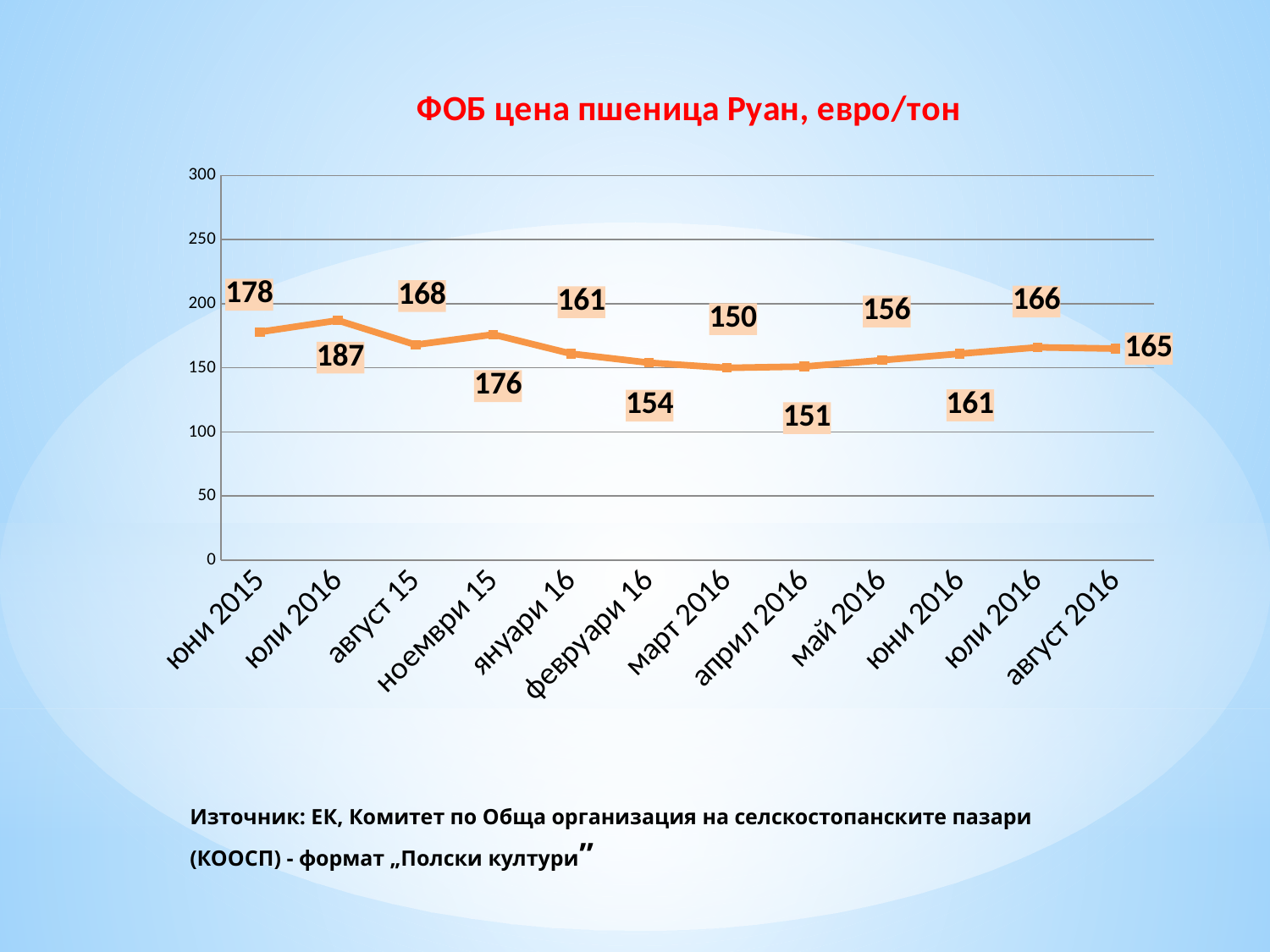
Does the value fall or rise from ноември 15 to януари 16? fall How many data points are plotted on the line? 12 What is the highest value plotted on the chart? 187 What is the value for ноември 15? 176 What is the value for юни 2015? 178 What is the value for март 2016? 150 Which category has the lowest value? март 2016 What is the difference between the values for юни 2015 and март 2016? 28 What kind of chart is shown on the slide? line chart What is the value for август 2016? 165 Which is larger, the value for май 2016 or the value for февруари 16? май 2016 What is the title of the chart? ФОБ цена пшеница Руан, евро/тон